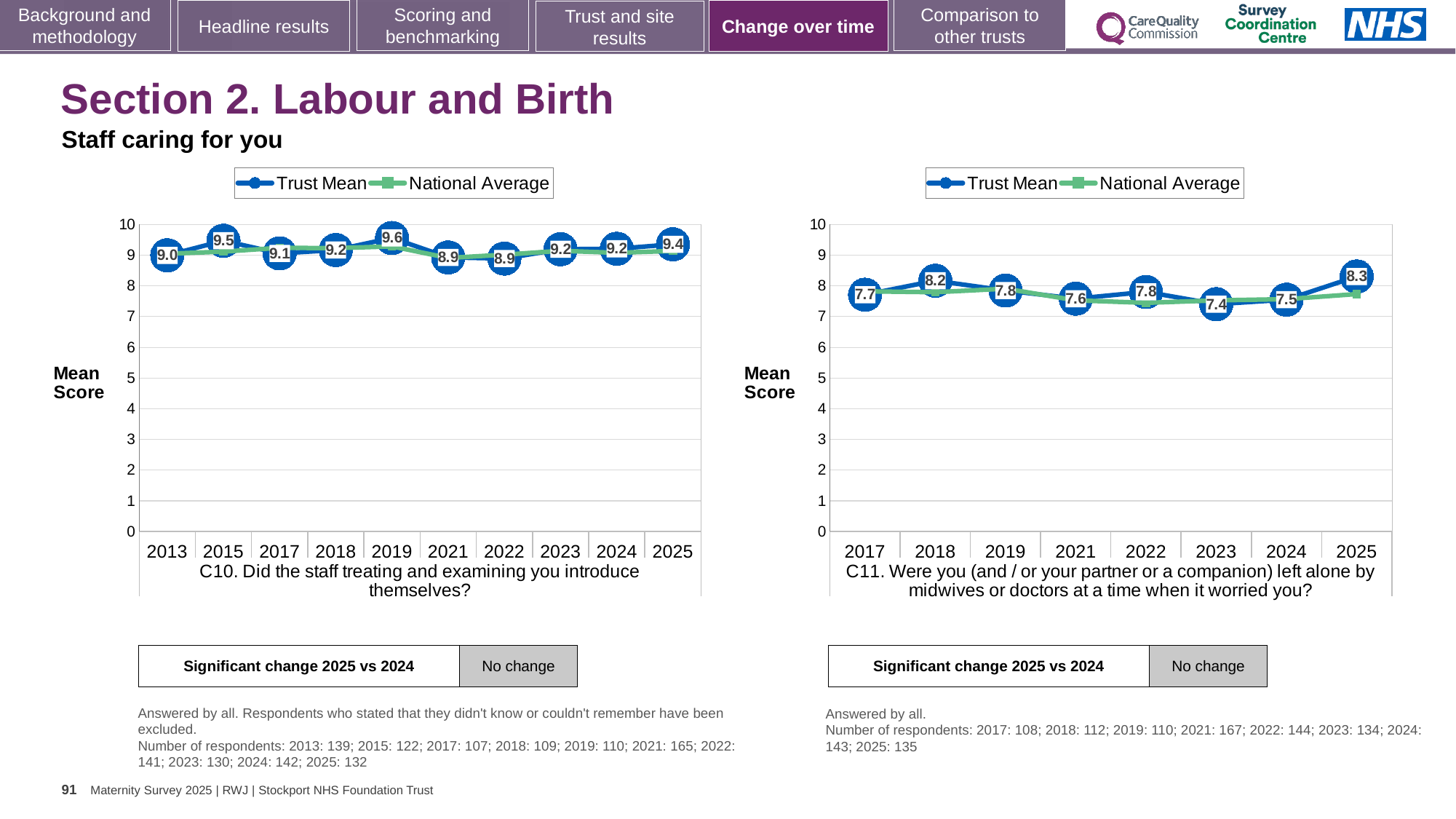
In the C10 chart (left), what is the Trust Mean for 2025? 9.4 In the C10 chart (left), what is the Trust Mean for 2019? 9.6 In the C10 chart (left), what is the difference between the Trust Mean in 2025 and in 2024? 0.2 In the C11 chart (right), how many series does the legend list? 2 In the C11 chart (right), what is the Trust Mean for 2023? 7.4 In the C11 chart (right), which year has the lowest Trust Mean? 2023 In the C10 chart (left), which year has the highest Trust Mean? 2019 In the C10 chart (left), is the Trust Mean for 2013 greater or less than 8? greater In the C11 chart (right), which year has the highest Trust Mean? 2025 In the C11 chart (right), which is larger, the Trust Mean for 2018 or for 2021? 2018 What kind of chart is the C11 chart (right)? Line chart In the C10 chart (left), how many years are plotted on the x axis? 10